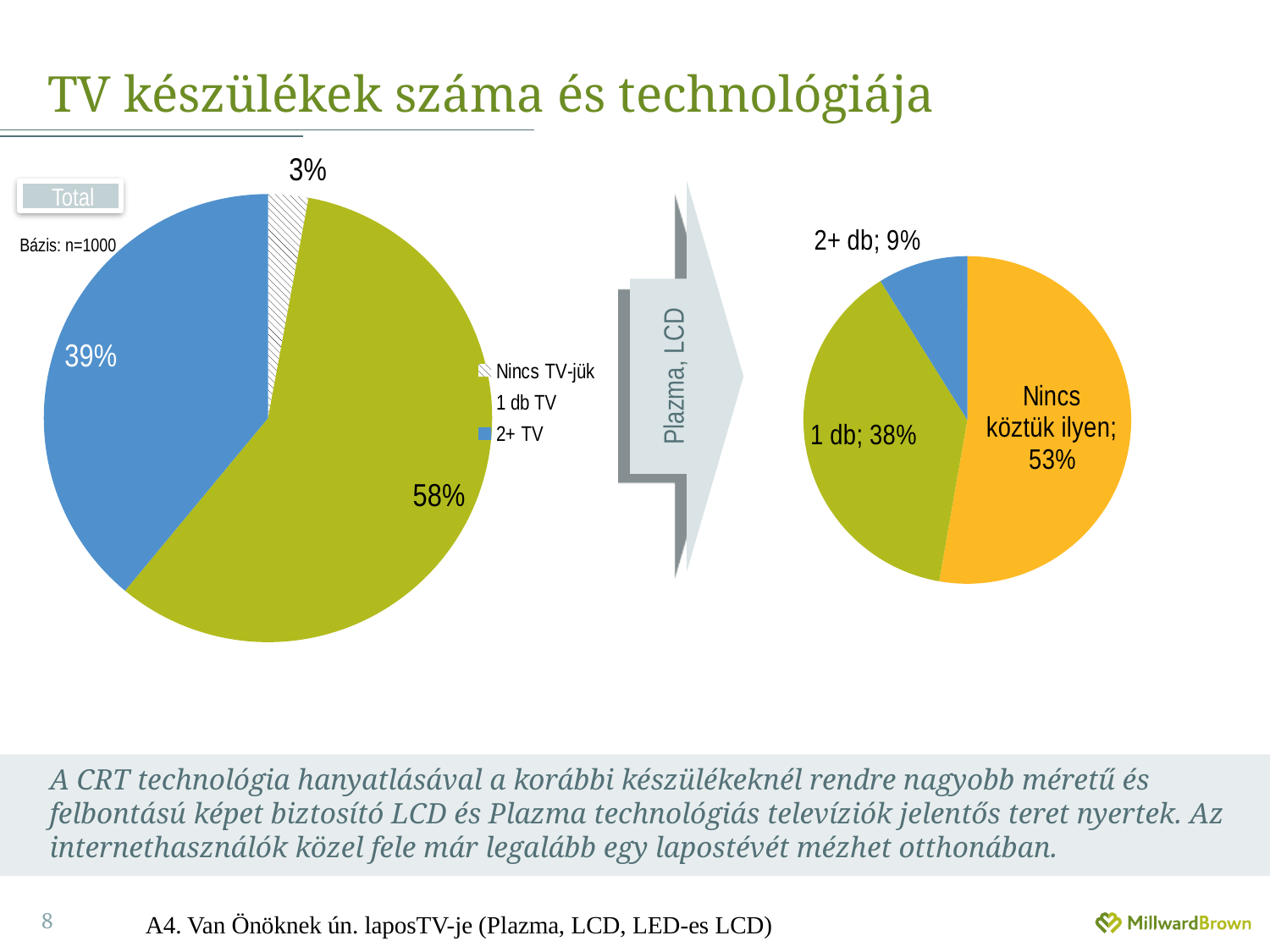
In the left pie chart (Total), what is the difference in percentage points between 1 db TV and 2+ TV? 19 In the left pie chart (Total), which category has the smallest slice? Nincs TV-jük In the right pie chart (Plazma, LCD), what share is labelled for Nincs köztük ilyen? 53% In the left pie chart (Total), what share is labelled for Nincs TV-jük? 3% In the right pie chart (Plazma, LCD), which category has the largest slice? Nincs köztük ilyen What type of chart is the left chart (Total)? Pie chart In the left pie chart (Total), what share is labelled for 2+ TV? 39% In the left pie chart (Total), which category has the largest slice? 1 db TV How many slices does the right pie chart (Plazma, LCD) have? 3 In the right pie chart (Plazma, LCD), what share is labelled for 2+ db? 9% In the right pie chart (Plazma, LCD), what share is labelled for 1 db? 38% In the left pie chart (Total), what share is labelled for 1 db TV? 58%